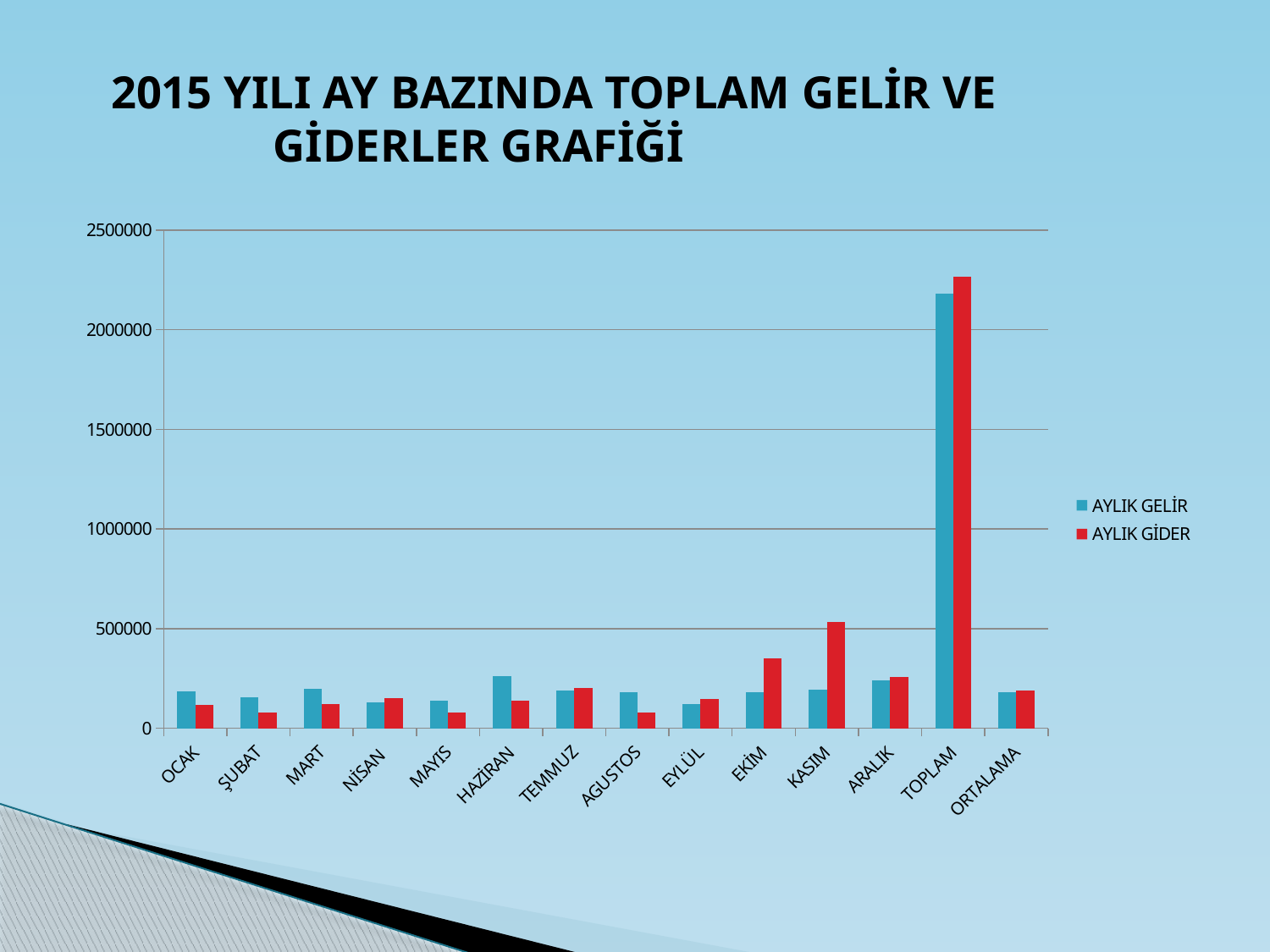
Which category has the highest AYLIK GİDER value? TOPLAM Is the AYLIK GİDER value for TOPLAM greater or less than 2500000? less For KASIM, which is larger: AYLIK GELİR or AYLIK GİDER? AYLIK GİDER How many series does the legend list? 2 Which colour represents the AYLIK GİDER series? red What kind of chart is shown on the slide? bar chart Excluding TOPLAM, which category has the highest AYLIK GİDER value? KASIM How many categories are shown on the x axis? 14 Which category has the highest AYLIK GELİR value? TOPLAM Is the AYLIK GELİR value for TOPLAM greater or less than 2000000? greater For HAZİRAN, which is larger: AYLIK GELİR or AYLIK GİDER? AYLIK GELİR Is the AYLIK GİDER value for KASIM greater or less than 1000000? less